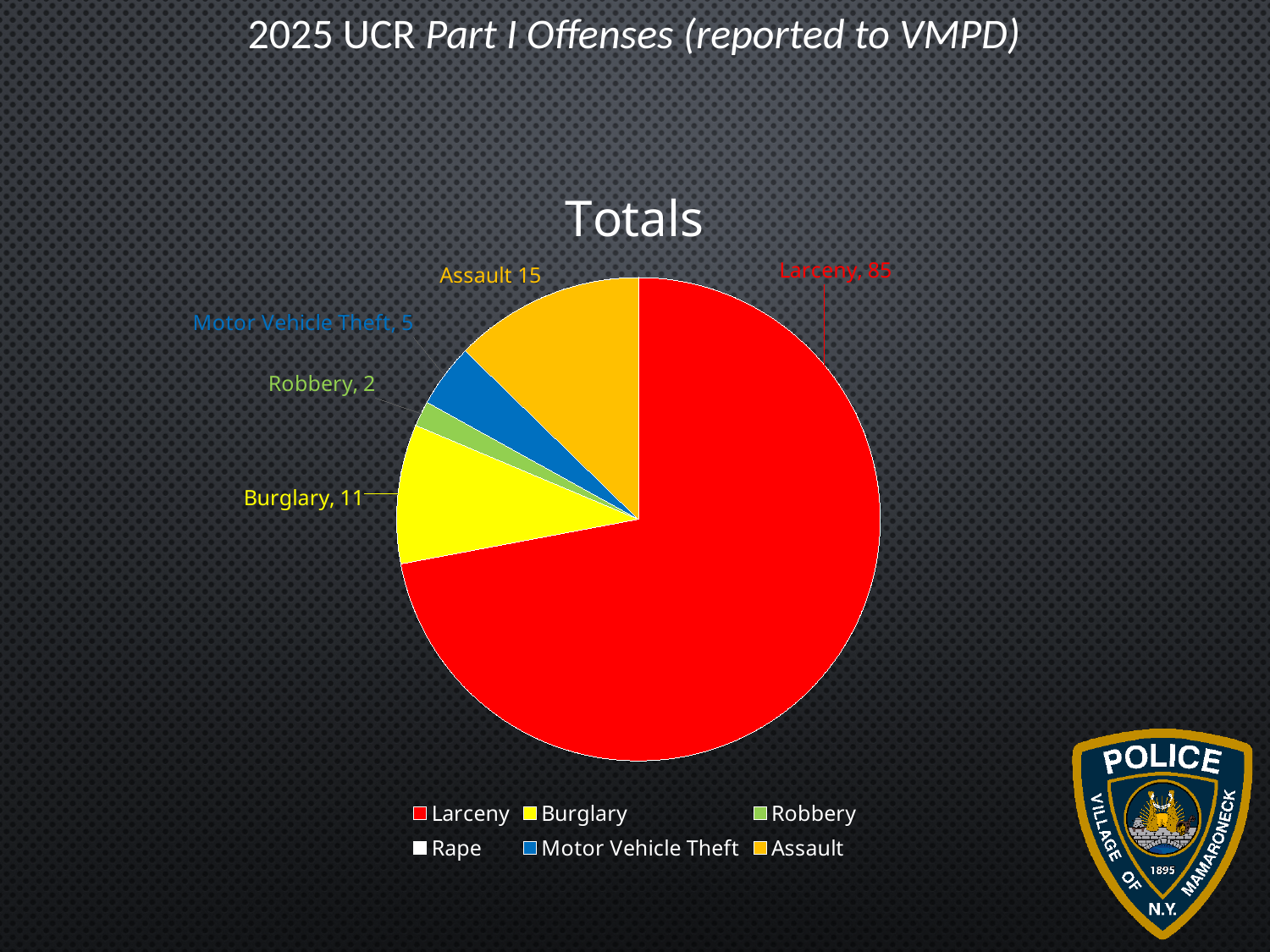
Which category has the largest slice in the Totals pie chart? Larceny What type of chart is shown on the slide? pie chart What is the value for Motor Vehicle Theft in the Totals pie chart? 5 What is the value for Robbery in the Totals pie chart? 2 What is the value for Larceny in the Totals pie chart? 85 What is the difference between the Larceny and Assault values? 70 Which is larger, Assault or Burglary? Assault What is the difference between the Burglary and Motor Vehicle Theft values? 6 Which labeled category has the smallest slice in the Totals pie chart? Robbery What is the value for Burglary in the Totals pie chart? 11 What is the value for Assault in the Totals pie chart? 15 How many categories does the legend list? 6